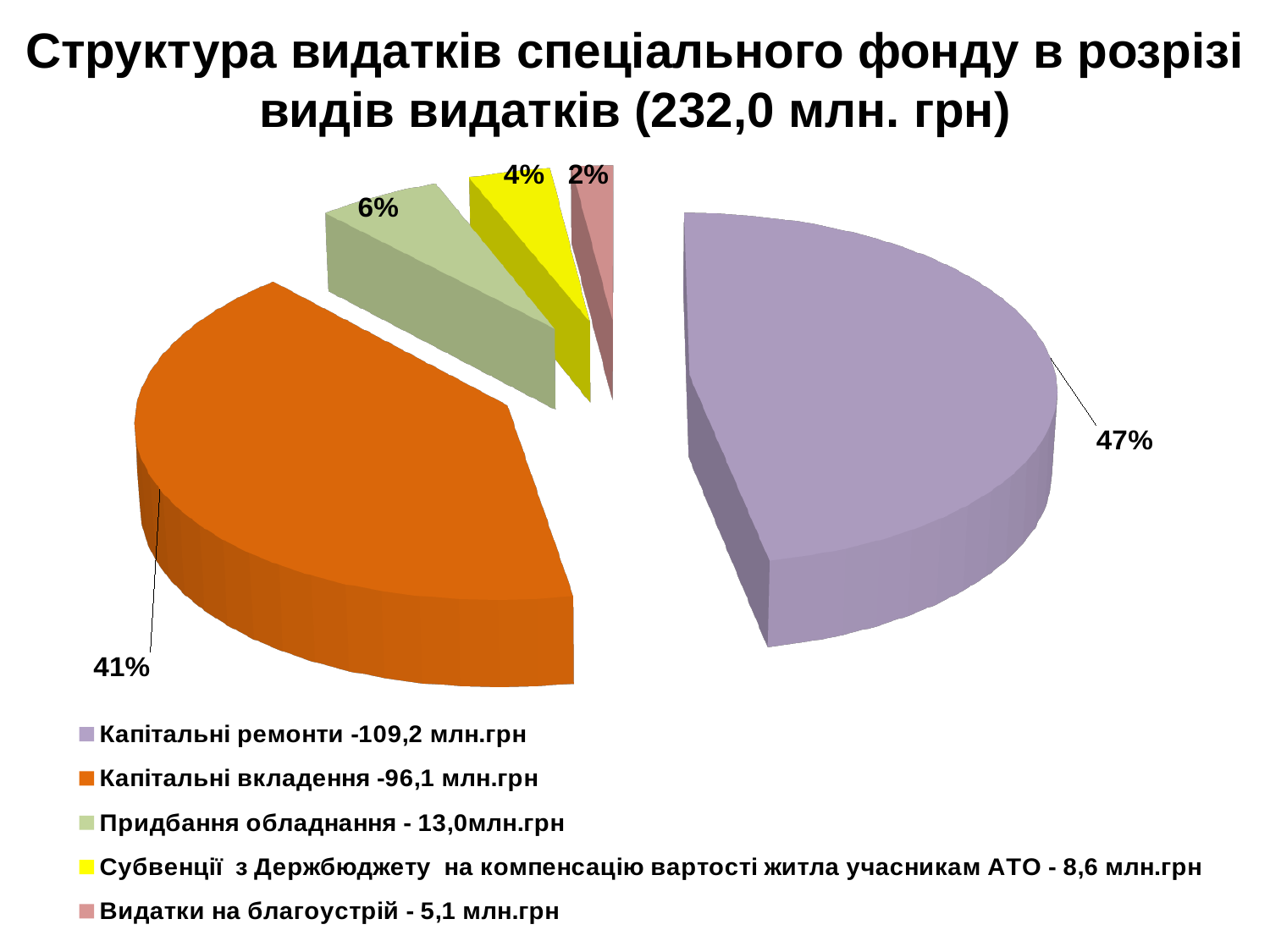
What amount in млн.грн does the legend give for "Капітальні вкладення"? 96,1 млн.грн Which slice is larger: "Придбання обладнання" or "Субвенції з Держбюджету на компенсацію вартості житла учасникам АТО"? Придбання обладнання What share of the pie does "Капітальні ремонти" take? 47% What kind of chart is shown on the slide? Pie chart What share of the pie does "Придбання обладнання" take? 6% What share of the pie does "Капітальні вкладення" take? 41% How many slices does the pie chart have? 5 What is the difference in percentage points between the "Капітальні ремонти" slice and the "Капітальні вкладення" slice? 6 What colour is the slice for "Субвенції з Держбюджету на компенсацію вартості житла учасникам АТО"? Yellow Which category has the largest slice of the pie? Капітальні ремонти Which category has the smallest slice of the pie? Видатки на благоустрій